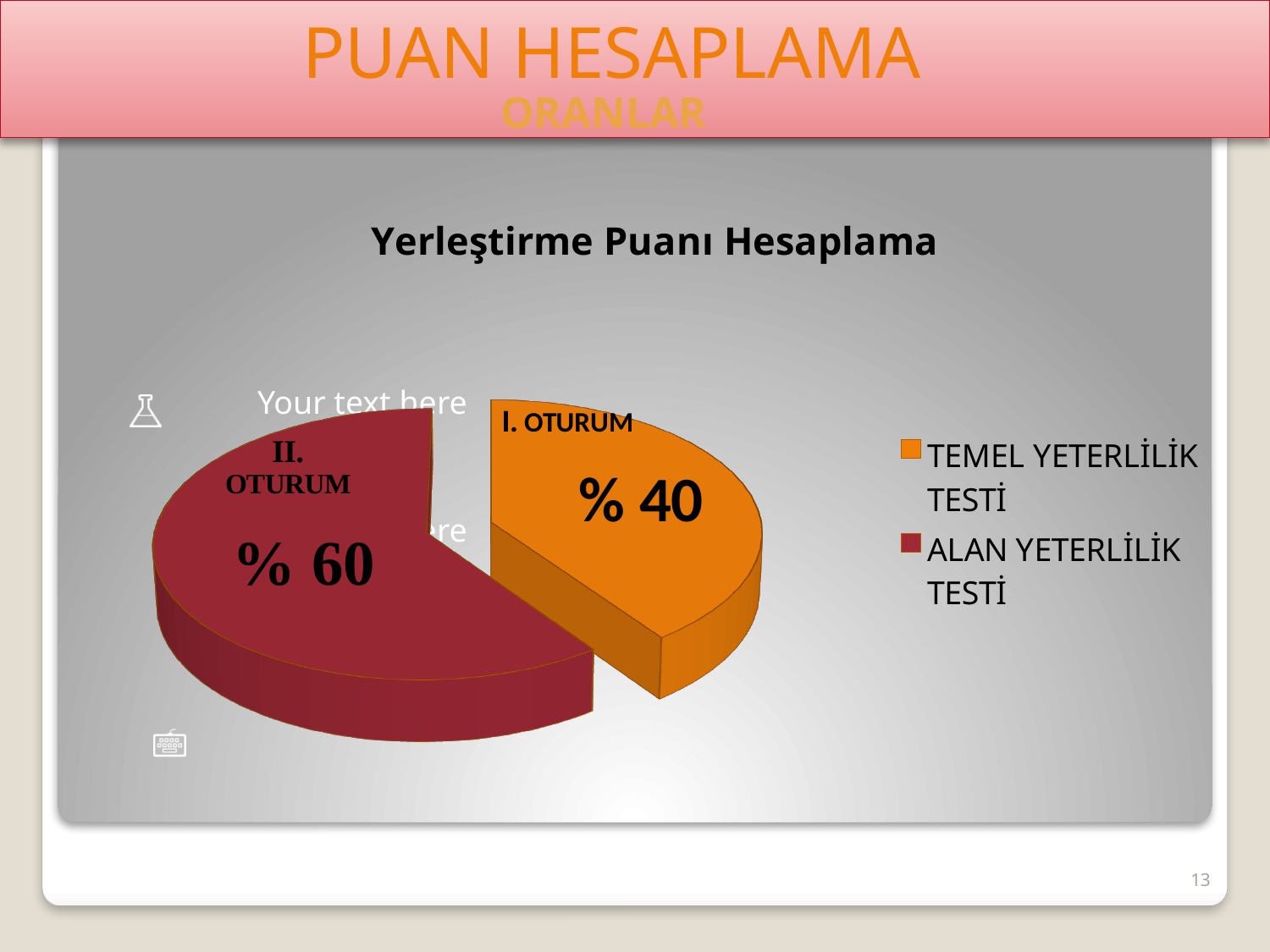
How many entries does the legend list? 2 What is the title of the chart? Yerleştirme Puanı Hesaplama What is the difference between the II. OTURUM value and the I. OTURUM value? % 20 What value is shown for the I. OTURUM slice? % 40 Which slice of the pie is the largest? II. OTURUM What kind of chart is shown on the slide? pie chart What value is shown for the II. OTURUM slice? % 60 Which slice of the pie is the smallest? I. OTURUM Which legend entry is shown in orange? TEMEL YETERLİLİK TESTİ What share of the pie does the I. OTURUM slice represent? % 40 Which is larger, the I. OTURUM slice or the II. OTURUM slice? II. OTURUM How many slices does the pie chart have? 2